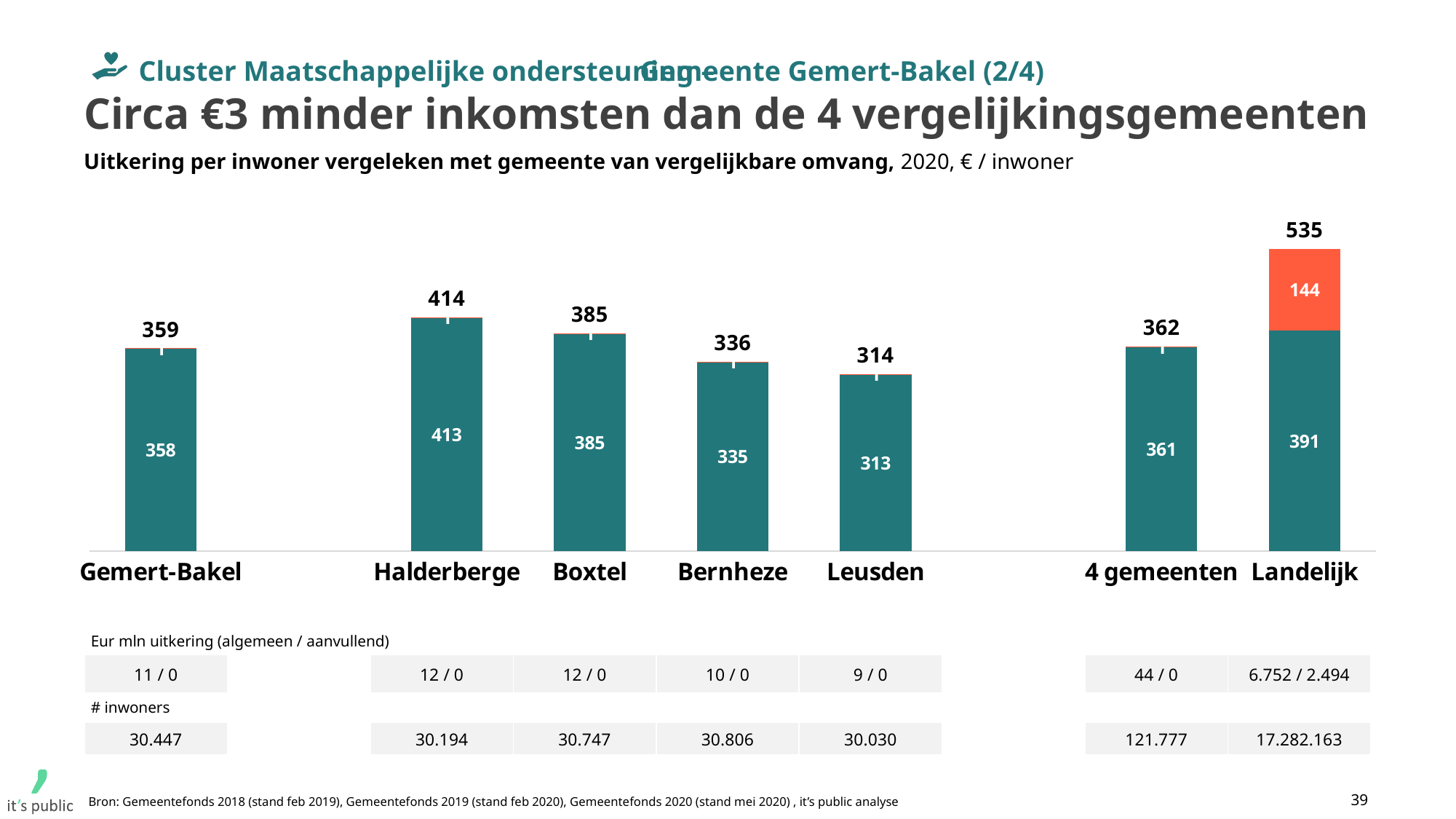
What is the difference between the total for Halderberge and the total for Gemert-Bakel? 55 What is the difference between the total for 4 gemeenten and the total for Gemert-Bakel? 3 Which category has the lowest total value? Leusden What is the total value shown above the bar for Landelijk? 535 What is the value of the teal (bottom) segment of the Halderberge bar? 413 What is the total value shown above the bar for Gemert-Bakel? 359 What is the total of the stacked bar for Landelijk, adding the teal segment 391 and the orange segment 144? 535 Which category has the highest total value? Landelijk What kind of chart is shown on the slide? Stacked bar chart What is the value of the orange (top) segment of the Landelijk bar? 144 How many categories are shown on the x axis of the chart? 7 Which has a larger total value, Boxtel or Bernheze? Boxtel